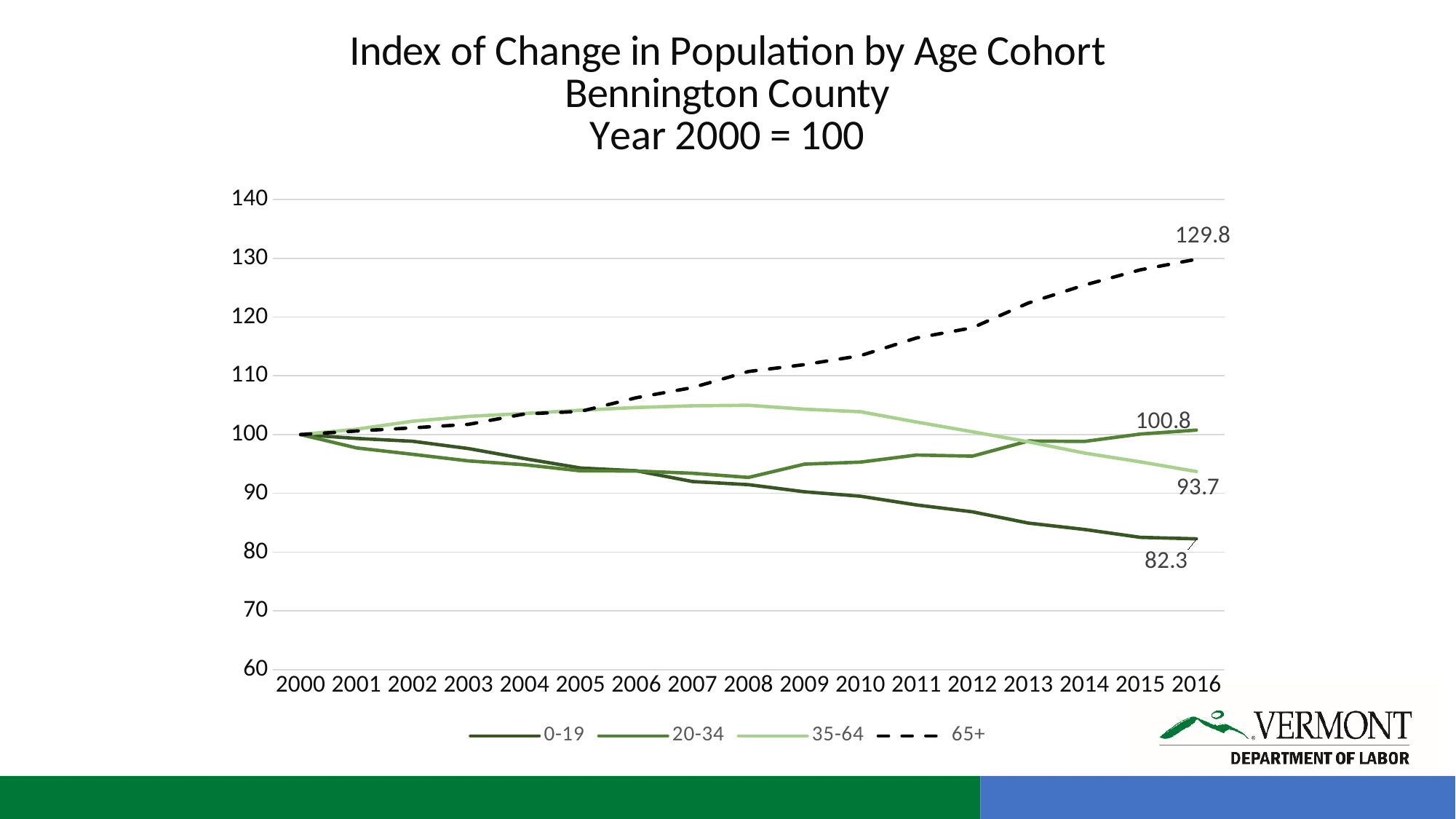
What is the 2016 index value for the 35-64 age cohort? 93.7 What is the 2016 index value for the 0-19 age cohort? 82.3 Does the index for the 0-19 cohort rise or fall from 2000 to 2016? fall What is the difference between the 2016 index values of the 65+ and 0-19 cohorts? 47.5 In 2016, which cohort has the larger index value, 20-34 or 35-64? 20-34 What is the 2016 index value for the 20-34 age cohort? 100.8 What type of chart is shown on the slide? line chart Which age cohort has the lowest index value in 2016? 0-19 Which age cohort has the highest index value in 2016? 65+ Is the index value for the 65+ cohort in 2013 greater or less than 110? greater What is the 2016 index value for the 65+ age cohort? 129.8 How many age cohorts are listed in the legend? 4